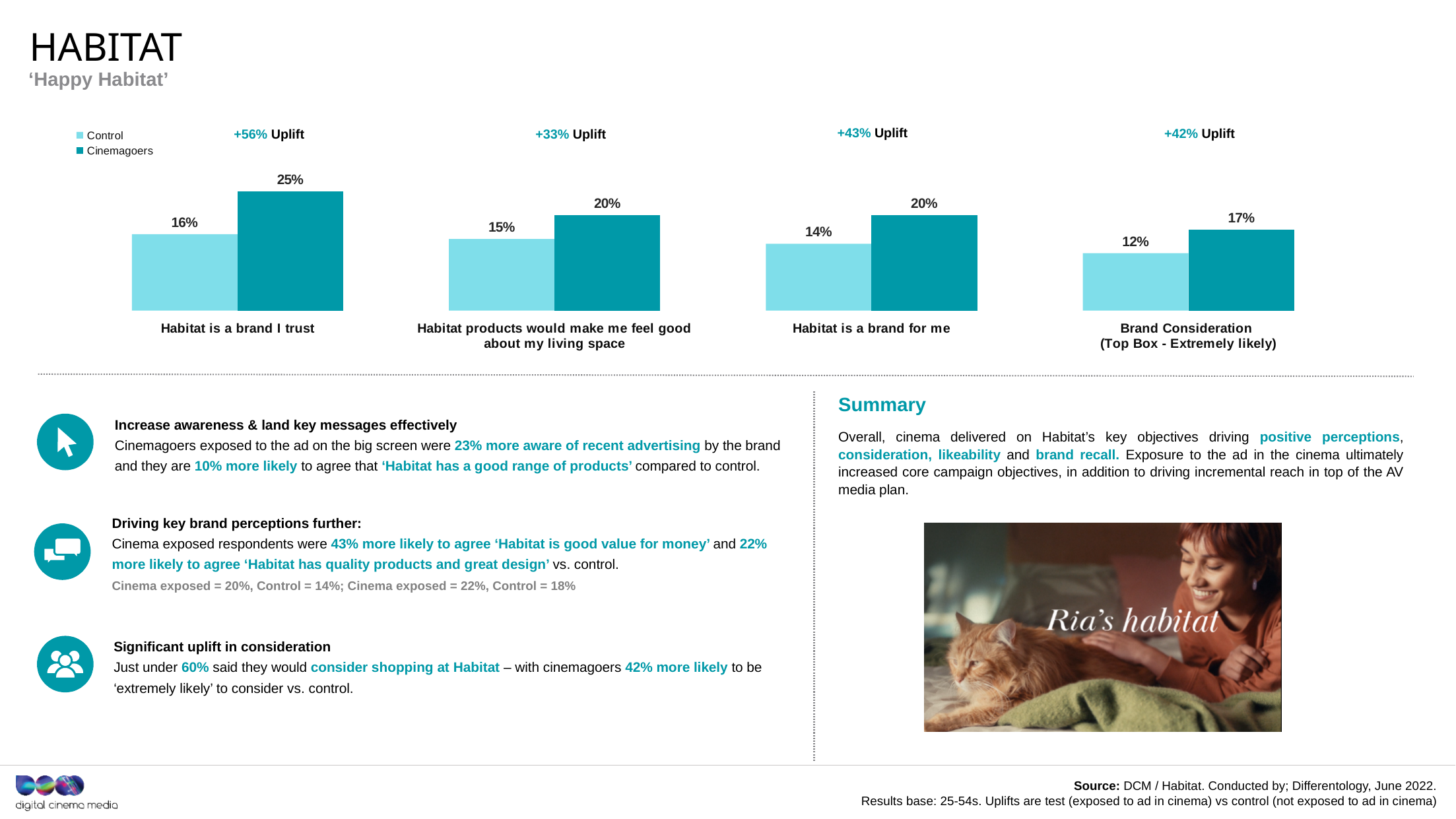
Across the four charts, which statement has the lowest Control value? Brand Consideration (Top Box - Extremely likely) How many series does the legend list for the charts? 2 In the 'Habitat is a brand I trust' chart, what is the value for Cinemagoers? 25% In the 'Brand Consideration (Top Box - Extremely likely)' chart, what is the value for Control? 12% In the 'Habitat is a brand for me' chart, which is larger, the Control value or the Cinemagoers value? Cinemagoers In the 'Habitat is a brand I trust' chart, what is the value for Control? 16% Across the four charts, which statement has the highest Cinemagoers value? Habitat is a brand I trust In the 'Brand Consideration (Top Box - Extremely likely)' chart, what is the difference between the Cinemagoers and Control values? 5% In the 'Habitat products would make me feel good about my living space' chart, what is the value for Control? 15% In the 'Habitat is a brand I trust' chart, what is the difference between the Cinemagoers and Control values? 9% What type of chart is used to show the Control and Cinemagoers values? Bar chart In the 'Habitat is a brand for me' chart, what is the value for Cinemagoers? 20%